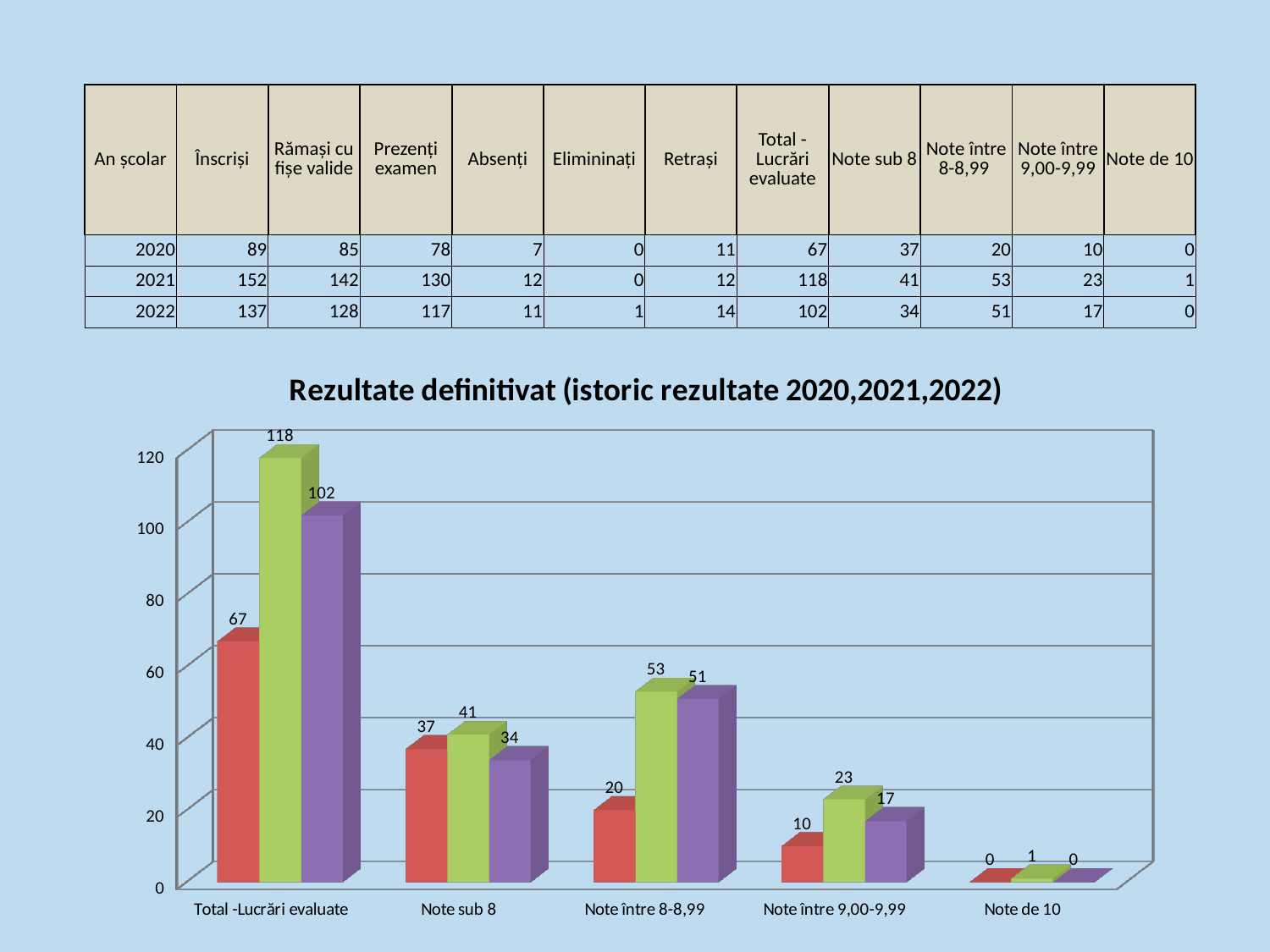
In the 'Note sub 8' category, which is larger: the red bar or the purple bar? the red bar What kind of chart is shown on the slide? bar chart What is the title of the chart? Rezultate definitivat (istoric rezultate 2020,2021,2022) How many categories are shown on the x axis of the chart? 5 What value is shown for the red bar in the 'Note între 8-8,99' category? 20 Do the red bars rise or fall from left to right across the categories? fall In which category is the green bar the highest? Total -Lucrări evaluate What value is shown for the green bar in the 'Total -Lucrări evaluate' category? 118 What is the sum of the three bars in the 'Note între 9,00-9,99' category? 50 In which category is the red bar the lowest? Note de 10 What value is shown for the purple bar in the 'Note sub 8' category? 34 What is the difference between the green bar and the purple bar in the 'Total -Lucrări evaluate' category? 16